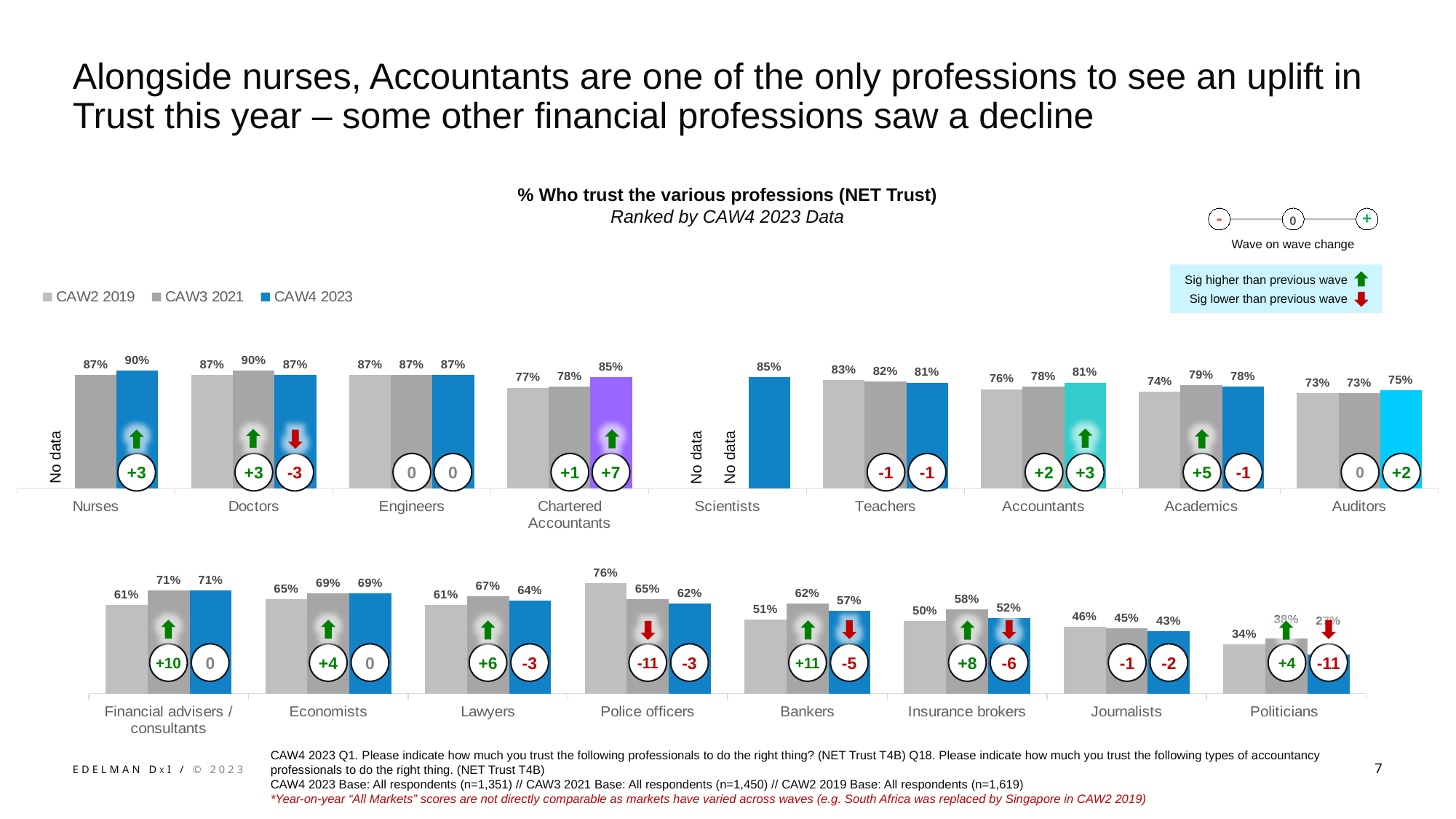
What is the CAW4 2023 value for Chartered Accountants? 85% Which profession has the highest CAW4 2023 value? Nurses How many professions are shown in the chart? 17 What is the title of the chart? % Who trust the various professions (NET Trust) Which is larger for Journalists: the CAW2 2019 value or the CAW4 2023 value? CAW2 2019 What is the CAW3 2021 value for Bankers? 62% How many series does the legend list? 3 What kind of chart is shown on the slide? Bar chart What is the difference between the CAW4 2023 and CAW2 2019 values for Accountants? 5% Which profession has the lowest CAW4 2023 value? Politicians Do the values for Politicians rise or fall from CAW3 2021 to CAW4 2023? Fall What is the CAW2 2019 value for Police officers? 76%